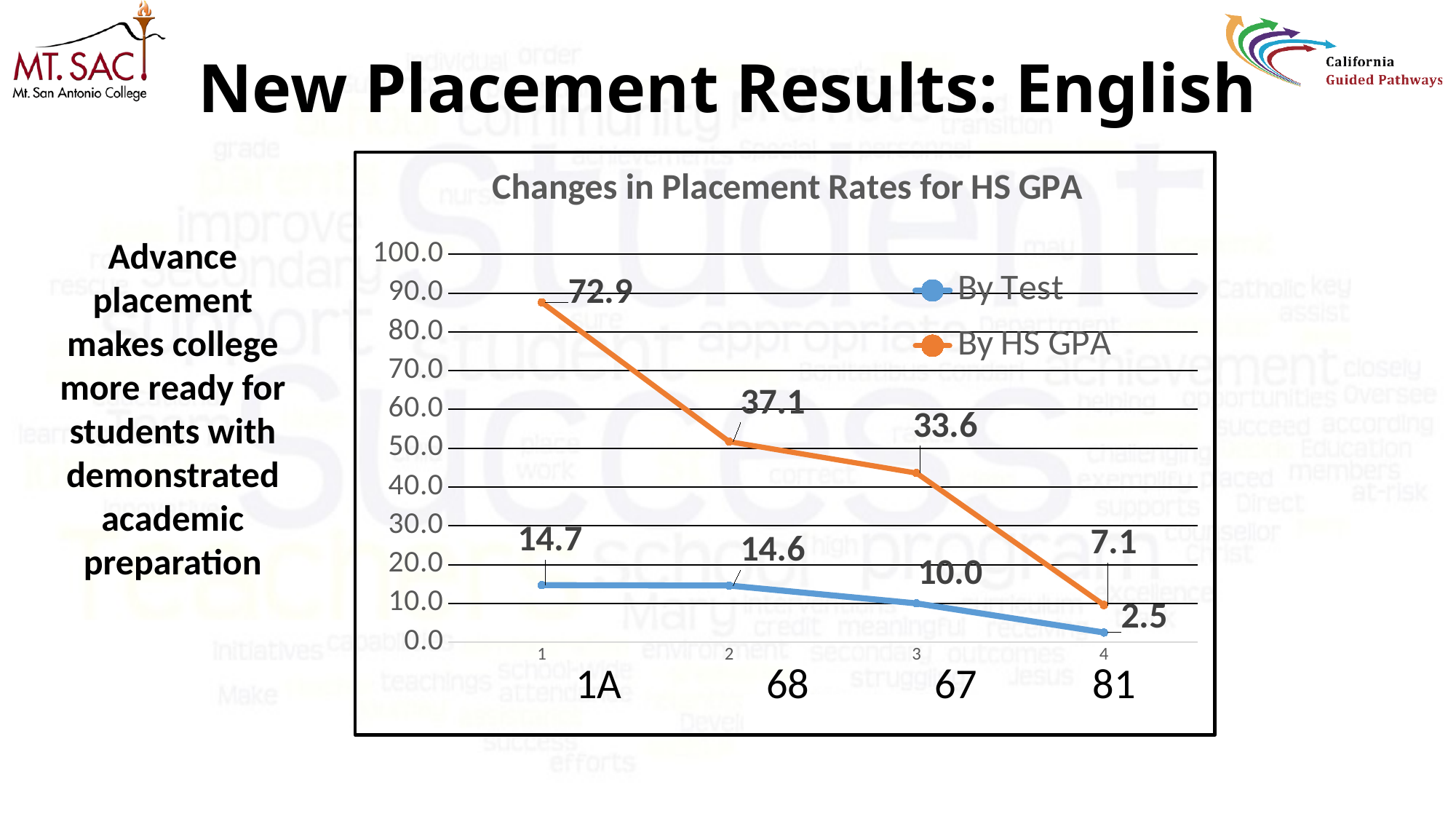
What is the labelled value for By HS GPA at category 1A? 72.9 What is the labelled value for By Test at category 67? 10.0 Which series has the larger value at category 67, By Test or By HS GPA? By HS GPA What is the title of the chart? Changes in Placement Rates for HS GPA How many categories are plotted along the x axis? 4 How many series does the chart legend list? 2 Which category has the lowest labelled value for By Test? 81 Do the By HS GPA values rise or fall from category 1A to category 81? fall Which category has the highest labelled value for By HS GPA? 1A What is the difference between the labelled By HS GPA value and the labelled By Test value at category 68? 22.5 What type of chart is shown on the slide? line chart What is the labelled value for By HS GPA at category 81? 7.1